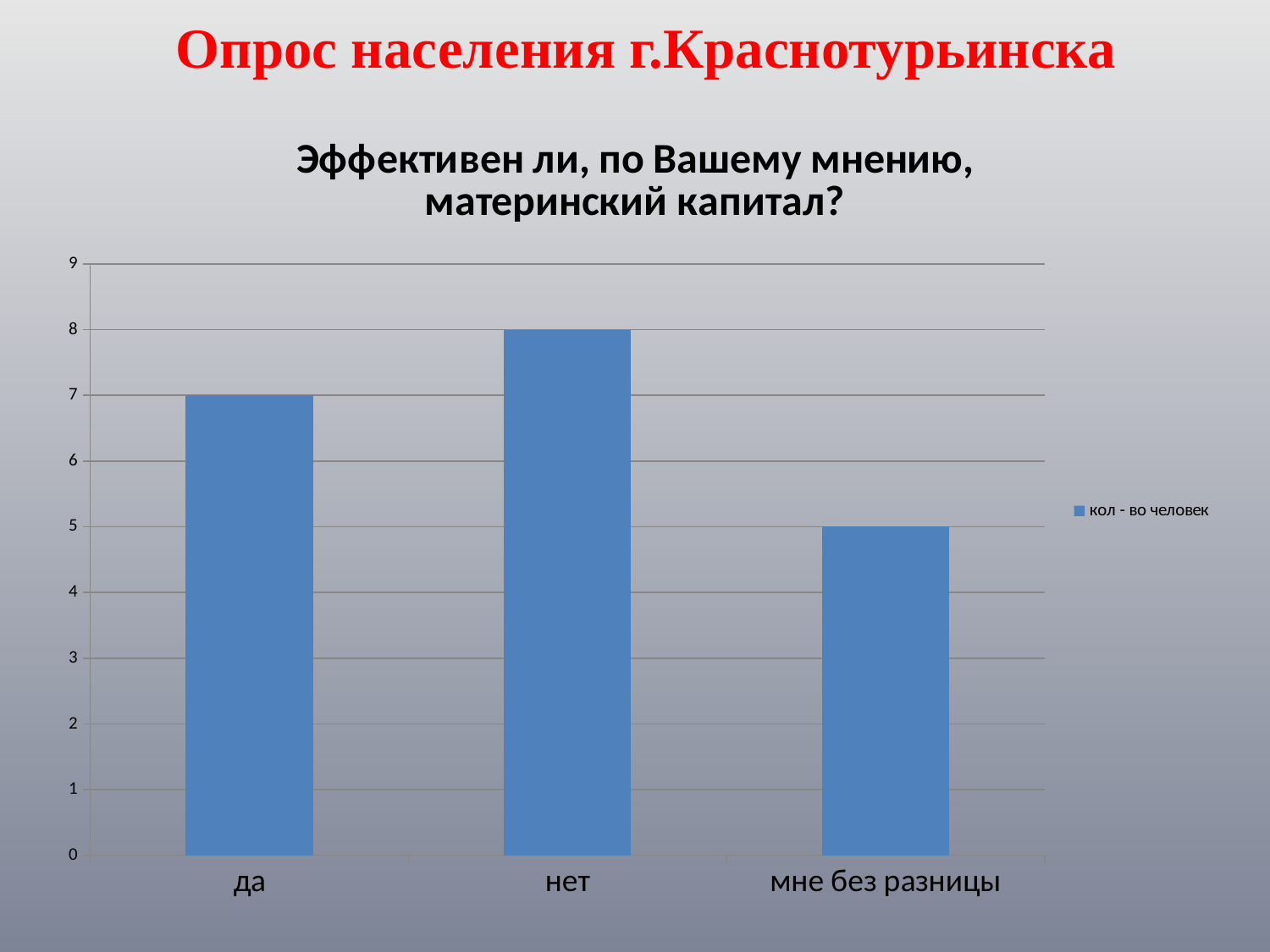
What kind of chart is shown on the slide? bar chart Which category has the highest value? нет What is the value for "мне без разницы"? 5 Which is larger, the value for "да" or the value for "мне без разницы"? да How many categories are shown on the x axis? 3 What is the difference between the values for "нет" and "да"? 1 Which category has the lowest value? мне без разницы Is the value for "нет" greater or less than 6? greater What is the difference between the values for "да" and "мне без разницы"? 2 What is the value for "нет"? 8 What is the value for "да"? 7 How many series does the legend list? 1